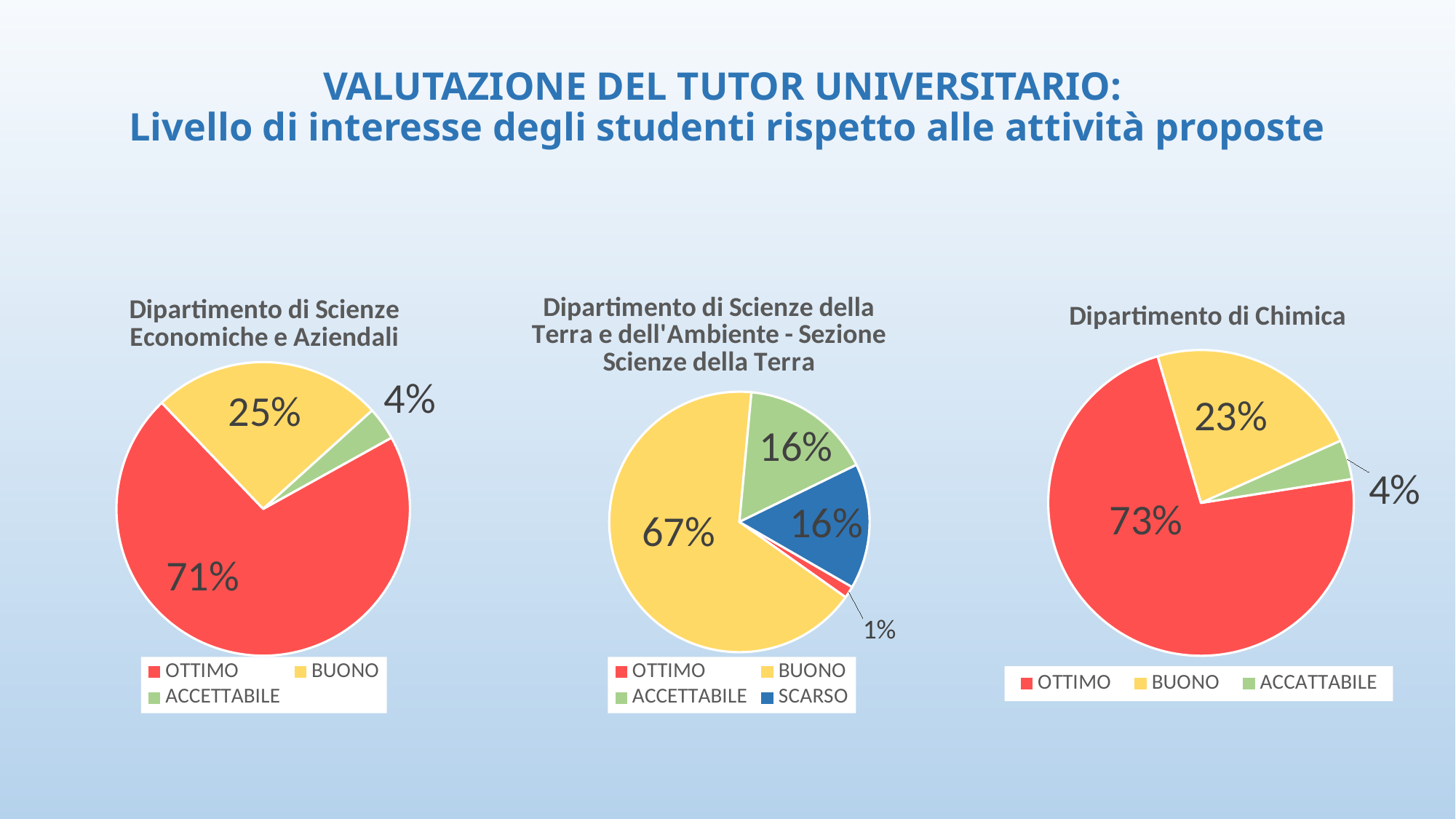
In the 'Dipartimento di Scienze della Terra e dell'Ambiente - Sezione Scienze della Terra' chart, what share is BUONO? 67% In the 'Dipartimento di Scienze della Terra e dell'Ambiente - Sezione Scienze della Terra' chart, what share is OTTIMO? 1% In the 'Dipartimento di Scienze della Terra e dell'Ambiente - Sezione Scienze della Terra' chart, what share is SCARSO? 16% In the 'Dipartimento di Scienze Economiche e Aziendali' chart, what share is BUONO? 25% Which is larger: the OTTIMO share in the 'Dipartimento di Chimica' chart or the OTTIMO share in the 'Dipartimento di Scienze Economiche e Aziendali' chart? Dipartimento di Chimica In the 'Dipartimento di Scienze Economiche e Aziendali' chart, which category has the smallest slice? ACCETTABILE In the 'Dipartimento di Scienze Economiche e Aziendali' chart, what share is OTTIMO? 71% In the 'Dipartimento di Chimica' chart, what is the difference between the OTTIMO and BUONO shares? 50% What kind of chart is used for the 'Dipartimento di Chimica' data? Pie chart In the 'Dipartimento di Chimica' chart, what share is OTTIMO? 73% How many pie charts are shown on the slide? 3 In the 'Dipartimento di Scienze della Terra e dell'Ambiente - Sezione Scienze della Terra' chart, how many categories does the legend list? 4